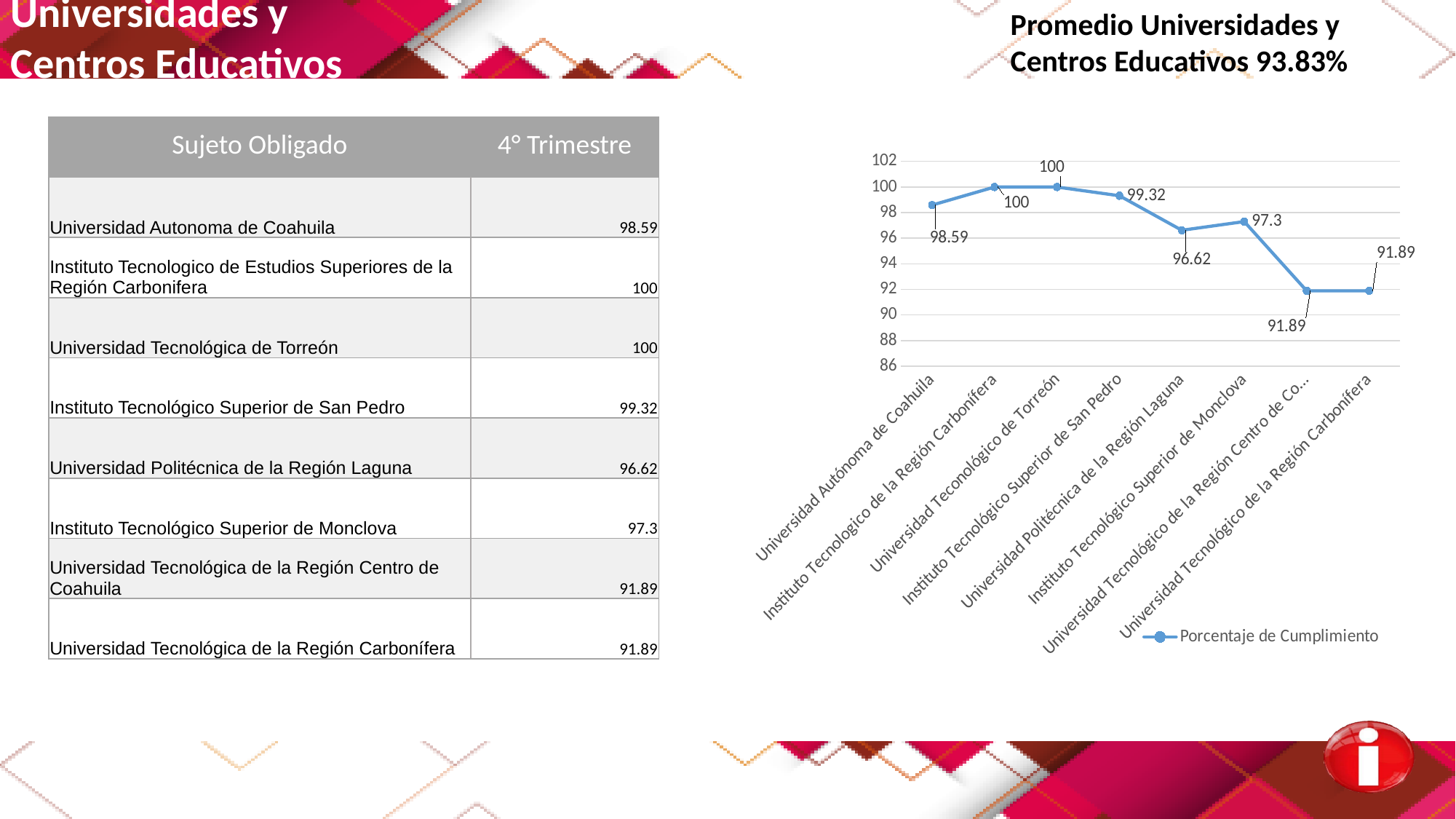
What is the value plotted for Instituto Tecnológico Superior de Monclova? 97.3 What is the highest value plotted on the chart? 100 How many data points are plotted on the chart? 8 What is the value plotted for Universidad Autónoma de Coahuila? 98.59 What is the value plotted for Instituto Tecnológico Superior de San Pedro? 99.32 What is the lowest value plotted on the chart? 91.89 What is the value plotted for Universidad Tecnológico de la Región Carbonífera? 91.89 Which has a larger value, Instituto Tecnológico Superior de Monclova or Universidad Politécnica de la Región Laguna? Instituto Tecnológico Superior de Monclova What kind of chart is shown on the slide? Line chart What is the value plotted for Universidad Politécnica de la Región Laguna? 96.62 What series name does the chart legend show? Porcentaje de Cumplimiento What is the difference between the values for Instituto Tecnológico Superior de San Pedro and Universidad Politécnica de la Región Laguna? 2.7